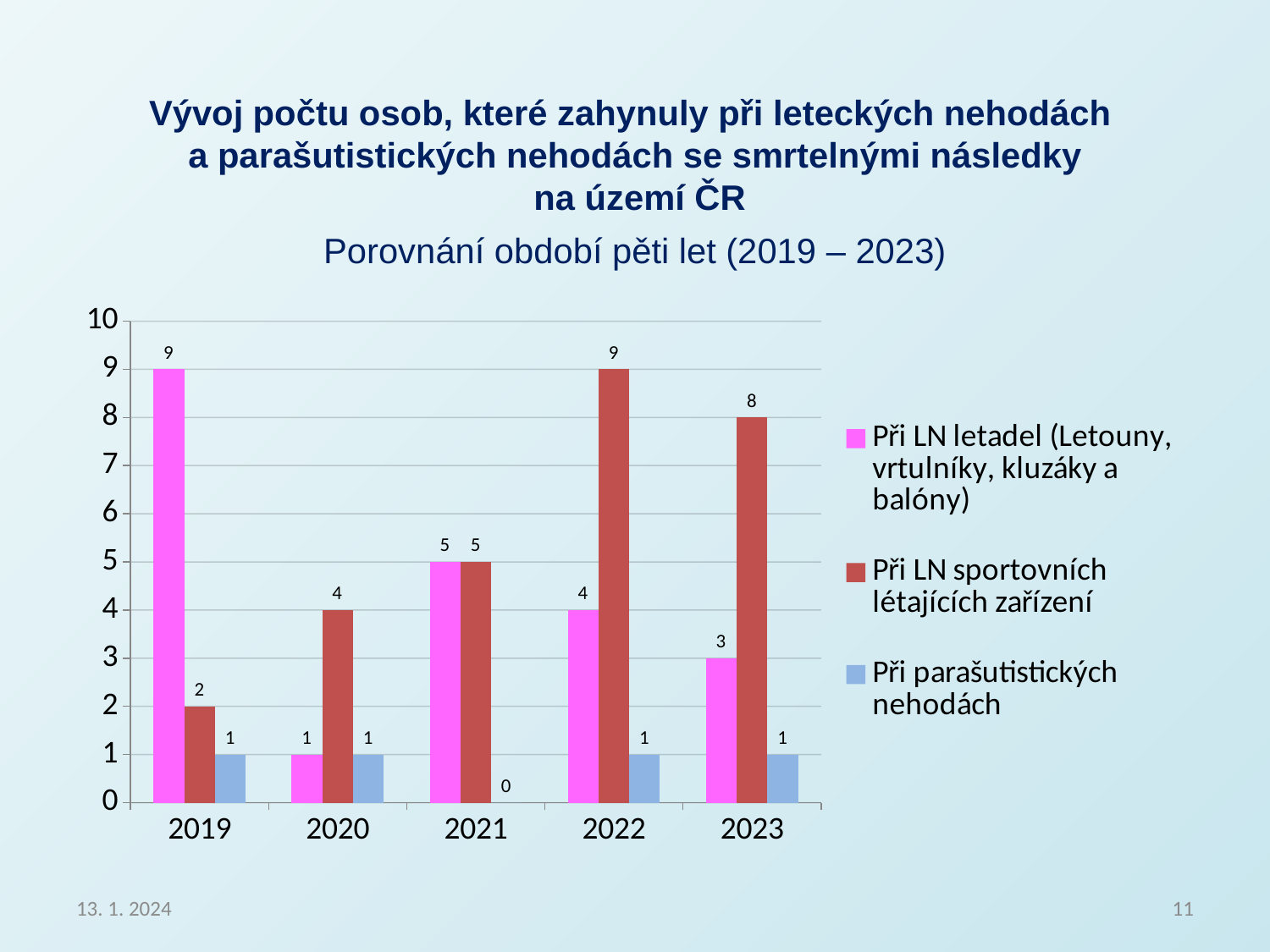
How many series does the legend list? 3 What colour are the bars for 'Při parašutistických nehodách'? light blue What is the difference between the 'Při LN sportovních létajících zařízení' value in 2023 and the 'Při LN letadel' value in 2023? 5 In which year is the value for 'Při LN letadel (Letouny, vrtulníky, kluzáky a balóny)' the highest? 2019 What is the value for 'Při parašutistických nehodách' in 2021? 0 What is the value for 'Při LN sportovních létajících zařízení' in 2022? 9 Does the value for 'Při LN sportovních létajících zařízení' rise or fall from 2019 to 2022? rise How many years are shown on the x axis? 5 Which is larger in 2020: the value for 'Při LN letadel' or for 'Při LN sportovních létajících zařízení'? Při LN sportovních létajících zařízení In which year is the value for 'Při LN sportovních létajících zařízení' the lowest? 2019 What kind of chart is shown on the slide? bar chart What is the value for 'Při LN letadel (Letouny, vrtulníky, kluzáky a balóny)' in 2019? 9